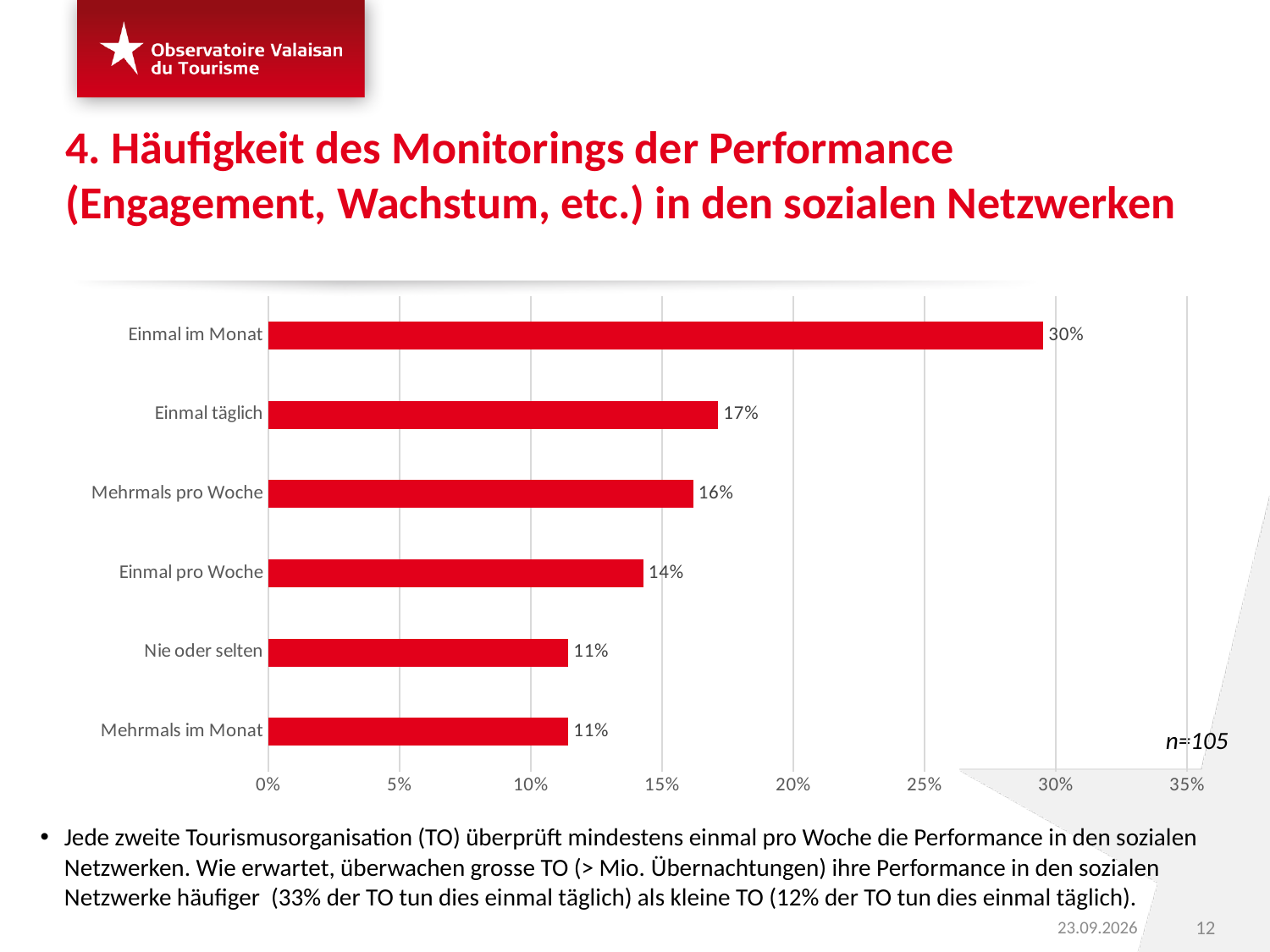
What kind of chart is shown on the slide? bar chart What sample size (n) is stated next to the chart? n=105 What is the difference between the values for "Mehrmals pro Woche" and "Einmal pro Woche"? 2% What is the value for "Einmal im Monat"? 30% What is the difference between the values for "Einmal im Monat" and "Einmal täglich"? 13% What is the value for "Einmal täglich"? 17% What is the value for "Einmal pro Woche"? 14% How many categories are shown in the chart? 6 Which category has the highest value? Einmal im Monat Is the value for "Mehrmals pro Woche" greater or less than 15%? greater What is the value for "Nie oder selten"? 11% Which is larger, the value for "Einmal täglich" or the value for "Einmal pro Woche"? Einmal täglich